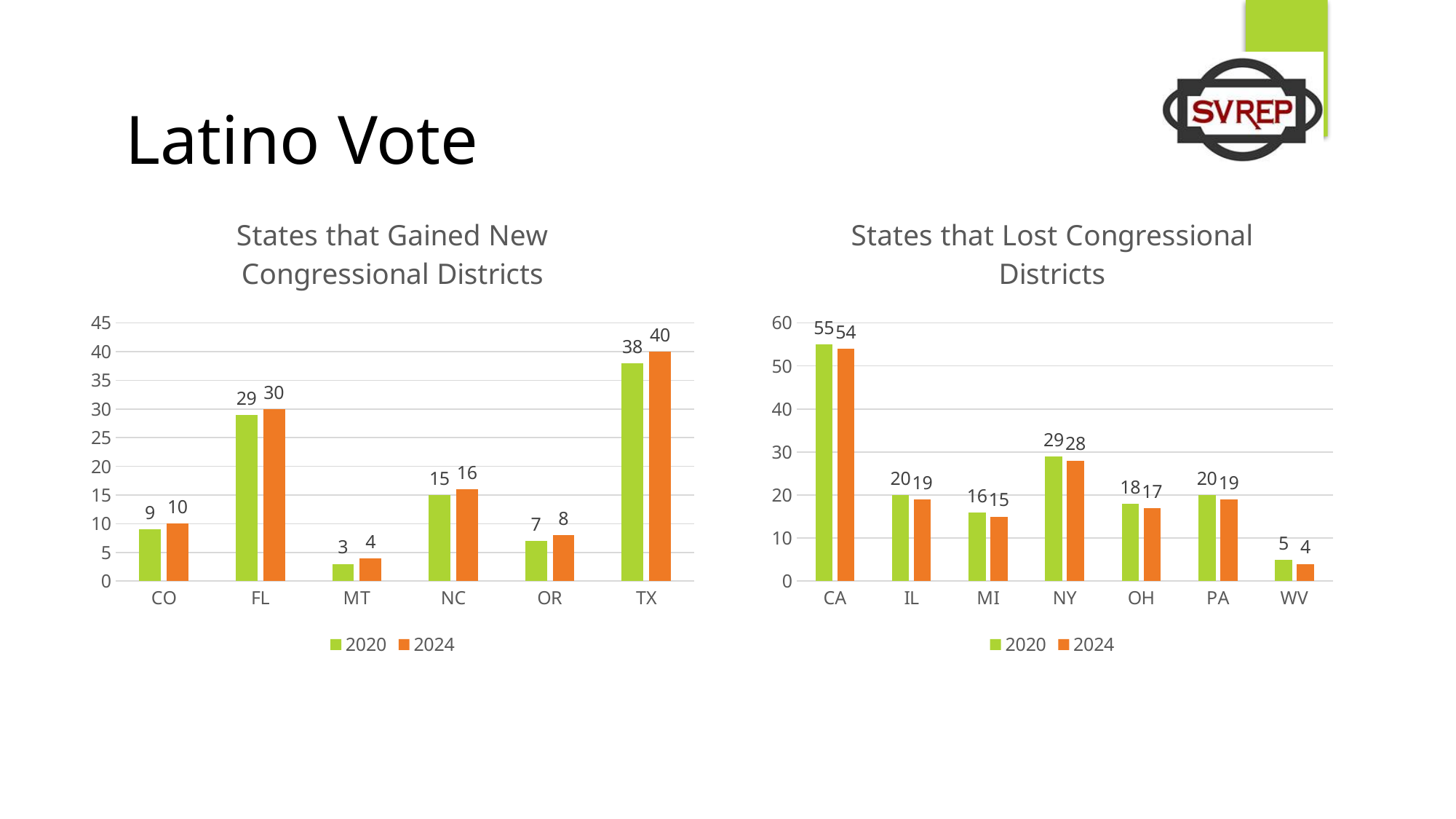
In the 'States that Lost Congressional Districts' chart, what is the 2020 value for CA? 55 In the 'States that Gained New Congressional Districts' chart, what is the 2024 value for TX? 40 In the 'States that Gained New Congressional Districts' chart, which state has the lowest 2020 value? MT In the 'States that Gained New Congressional Districts' chart, how many states are shown on the x axis? 6 In the 'States that Lost Congressional Districts' chart, which state has the highest 2024 value? CA In the 'States that Lost Congressional Districts' chart, what is the 2024 value for NY? 28 In the 'States that Gained New Congressional Districts' chart, what is the difference between the 2024 and 2020 values for TX? 2 In the 'States that Lost Congressional Districts' chart, how many states are shown on the x axis? 7 In the 'States that Lost Congressional Districts' chart, which is larger: the 2020 value for MI or the 2020 value for OH? OH In the 'States that Gained New Congressional Districts' chart, what is the 2020 value for FL? 29 In the 'States that Lost Congressional Districts' chart, how many series does the legend list? 2 What kind of chart is the 'States that Gained New Congressional Districts' chart? Bar chart